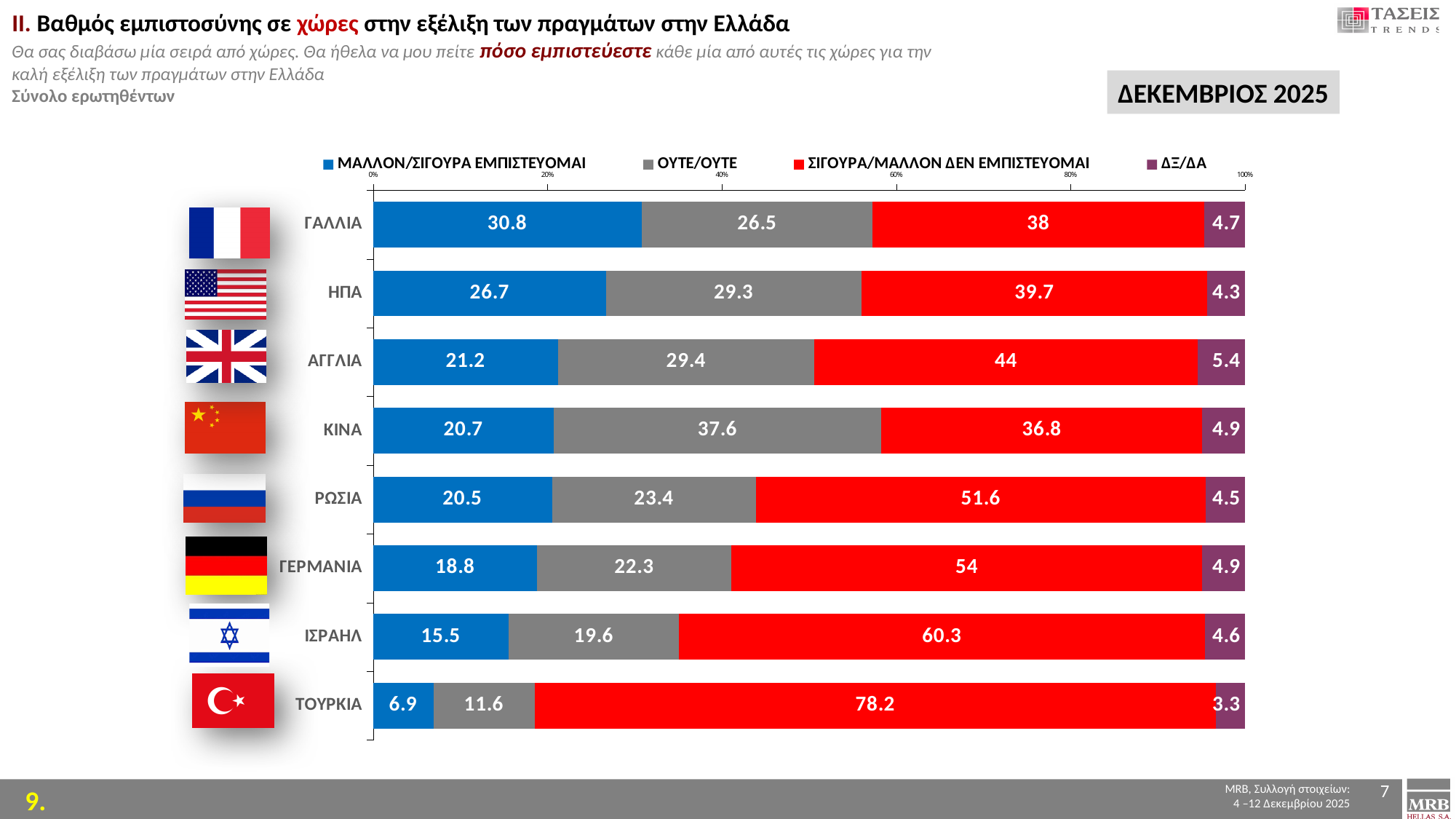
How many countries are shown in the chart? 8 What is the ΜΑΛΛΟΝ/ΣΙΓΟΥΡΑ ΕΜΠΙΣΤΕΥΟΜΑΙ value for ΓΑΛΛΙΑ? 30.8 What is the total of the stacked bar for ΡΩΣΙΑ? 100 What is the ΟΥΤΕ/ΟΥΤΕ value for ΚΙΝΑ? 37.6 Which country has the highest ΣΙΓΟΥΡΑ/ΜΑΛΛΟΝ ΔΕΝ ΕΜΠΙΣΤΕΥΟΜΑΙ value? ΤΟΥΡΚΙΑ Which is larger: the ΜΑΛΛΟΝ/ΣΙΓΟΥΡΑ ΕΜΠΙΣΤΕΥΟΜΑΙ value for ΗΠΑ or for ΑΓΓΛΙΑ? ΗΠΑ Which colour represents ΔΞ/ΔΑ in the chart? Purple How many series does the legend list? 4 What is the ΣΙΓΟΥΡΑ/ΜΑΛΛΟΝ ΔΕΝ ΕΜΠΙΣΤΕΥΟΜΑΙ value for ΤΟΥΡΚΙΑ? 78.2 What is the difference between the ΣΙΓΟΥΡΑ/ΜΑΛΛΟΝ ΔΕΝ ΕΜΠΙΣΤΕΥΟΜΑΙ values for ΙΣΡΑΗΛ and ΓΕΡΜΑΝΙΑ? 6.3 What kind of chart is shown on the slide? Stacked bar chart Which country has the lowest ΜΑΛΛΟΝ/ΣΙΓΟΥΡΑ ΕΜΠΙΣΤΕΥΟΜΑΙ value? ΤΟΥΡΚΙΑ